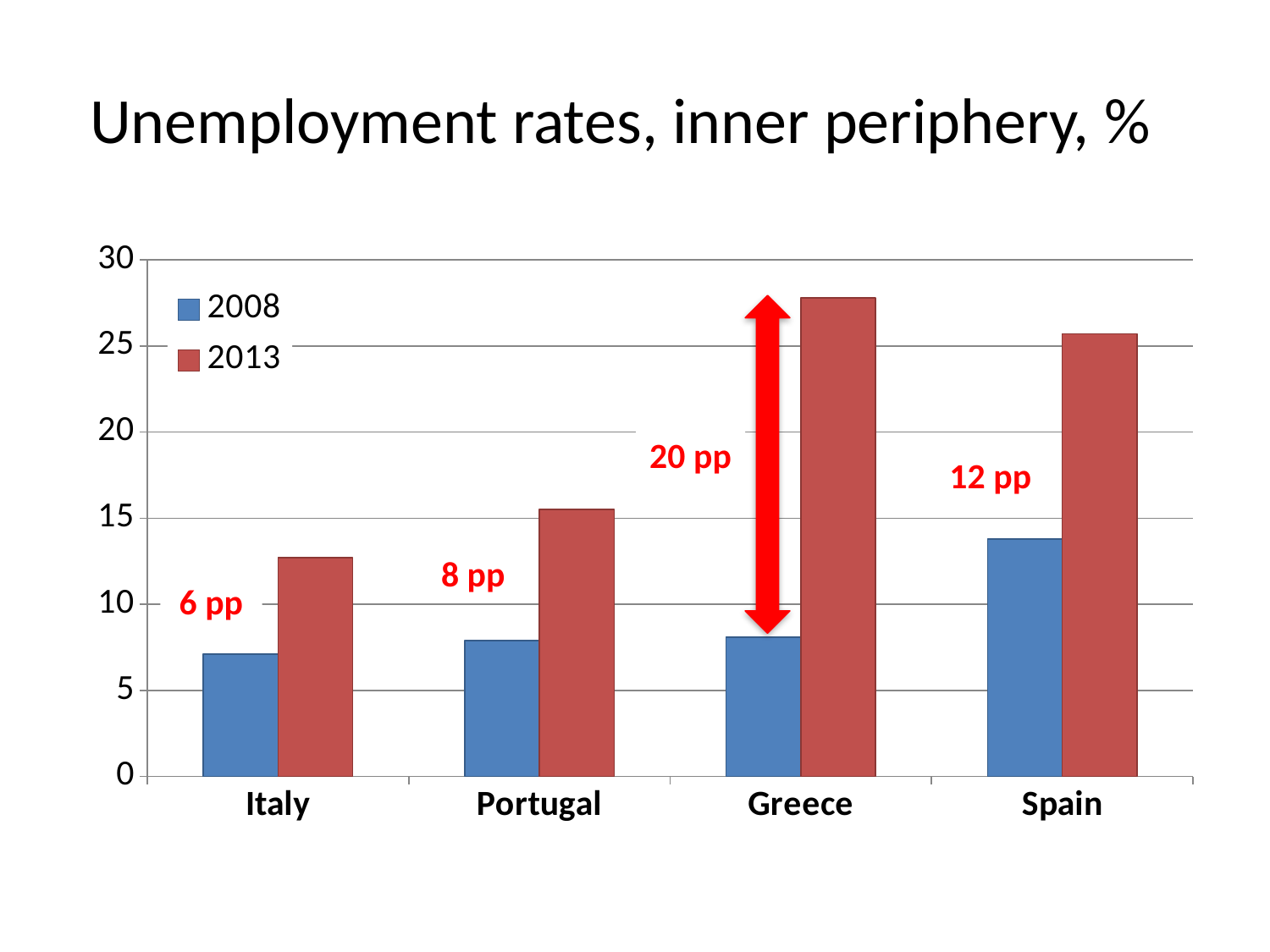
What kind of chart is shown on the slide? bar chart How many countries are shown on the x axis? 4 Which country has the lowest 2013 unemployment rate? Italy Is the 2013 value for Spain greater or less than 25? greater How many series does the legend list? 2 What is the title of the chart? Unemployment rates, inner periphery, % According to the annotation on the chart, by how many percentage points did Italy's unemployment rate rise between 2008 and 2013? 6 pp Is the 2008 value for Portugal greater or less than 10? less According to the annotation on the chart, by how many percentage points did Greece's unemployment rate rise between 2008 and 2013? 20 pp Which is larger, the 2013 value for Portugal or the 2013 value for Spain? Spain Which country has the highest 2008 unemployment rate? Spain Which country has the highest 2013 unemployment rate? Greece